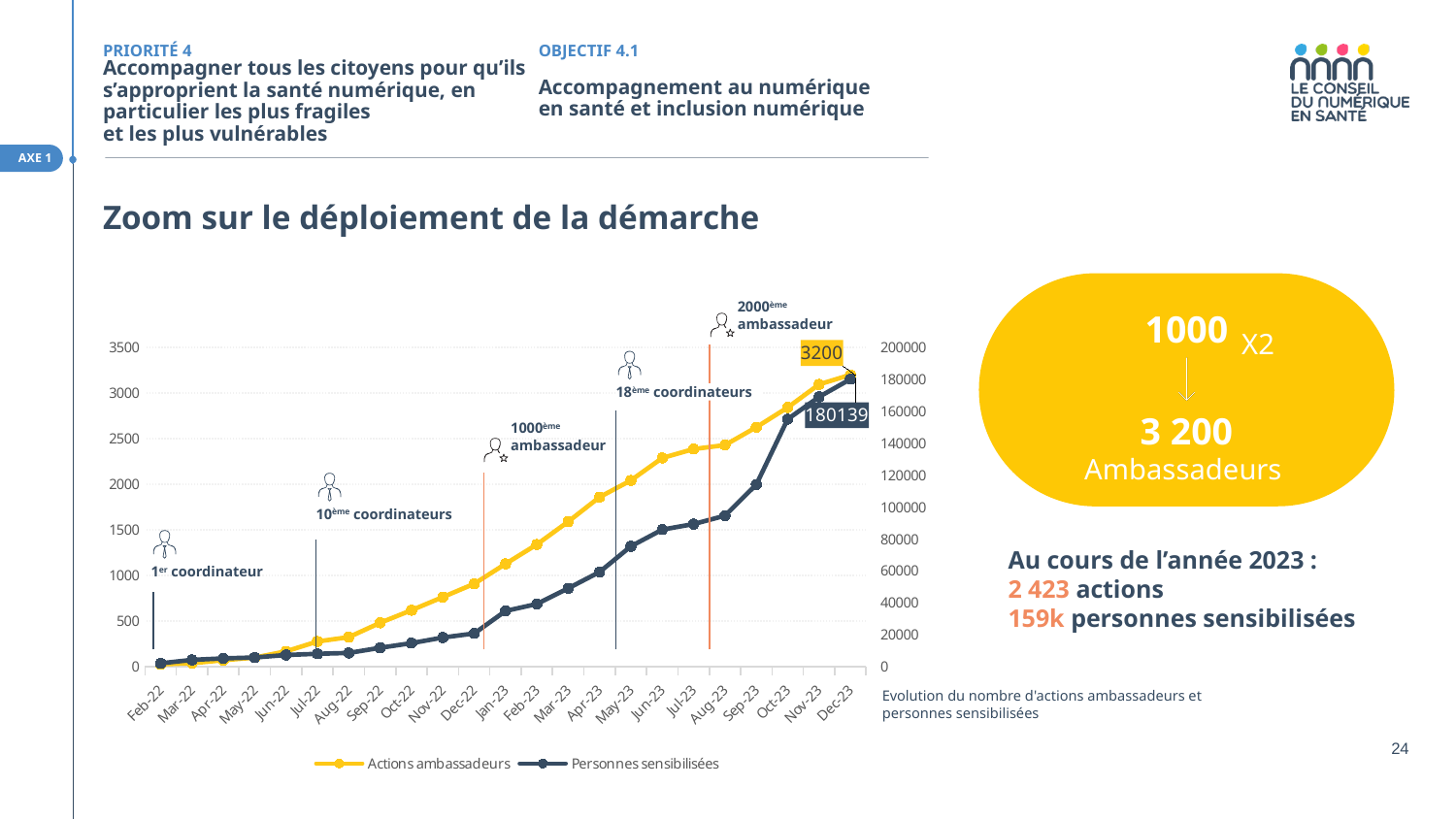
Do the values for Actions ambassadeurs rise or fall from Feb-22 to Dec-23? Rise How many series does the chart legend list? 2 How many months are shown on the x axis of the chart? 23 What is the value of Personnes sensibilisées at Dec-23? 180139 What are the two series named in the chart legend? Actions ambassadeurs and Personnes sensibilisées Is the value for Personnes sensibilisées at Oct-23 greater or less than 140000? greater Is the value for Actions ambassadeurs at Jun-23 greater or less than 2000? greater Is the value for Actions ambassadeurs at Jul-22 greater or less than 500? less What kind of chart is shown on the slide? Line chart What is the value of Actions ambassadeurs at Dec-23? 3200 In which month is the value for Actions ambassadeurs highest? Dec-23 In which month is the value for Actions ambassadeurs lowest? Feb-22